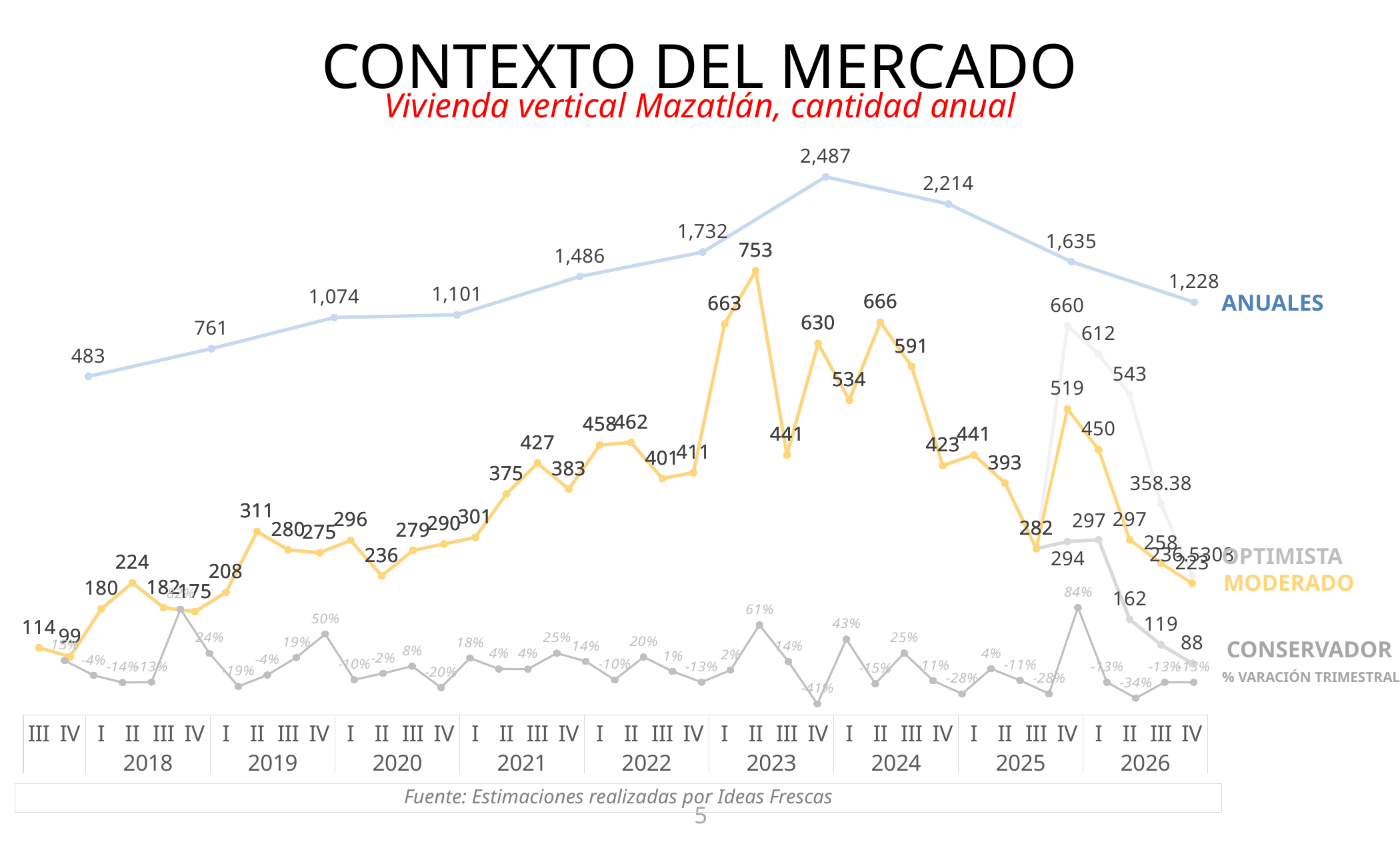
What is the highest quarterly value shown on the MODERADO line? 753 What is the difference between the ANUALES values for 2023 and 2024? 273 What is the ANUALES value for 2023? 2,487 How many data points does the ANUALES line have? 10 Does the ANUALES line rise or fall from 2023 to 2026? Falls What kind of chart is shown on the slide? Line chart Which year has the larger ANUALES value, 2019 or 2020? 2020 What is the ANUALES value for 2018? 761 What is the ANUALES value for 2026? 1,228 What is the difference between the ANUALES values for 2025 and 2026? 407 What is the red subtitle of the chart? Vivienda vertical Mazatlán, cantidad anual Which year has the highest ANUALES value? 2023